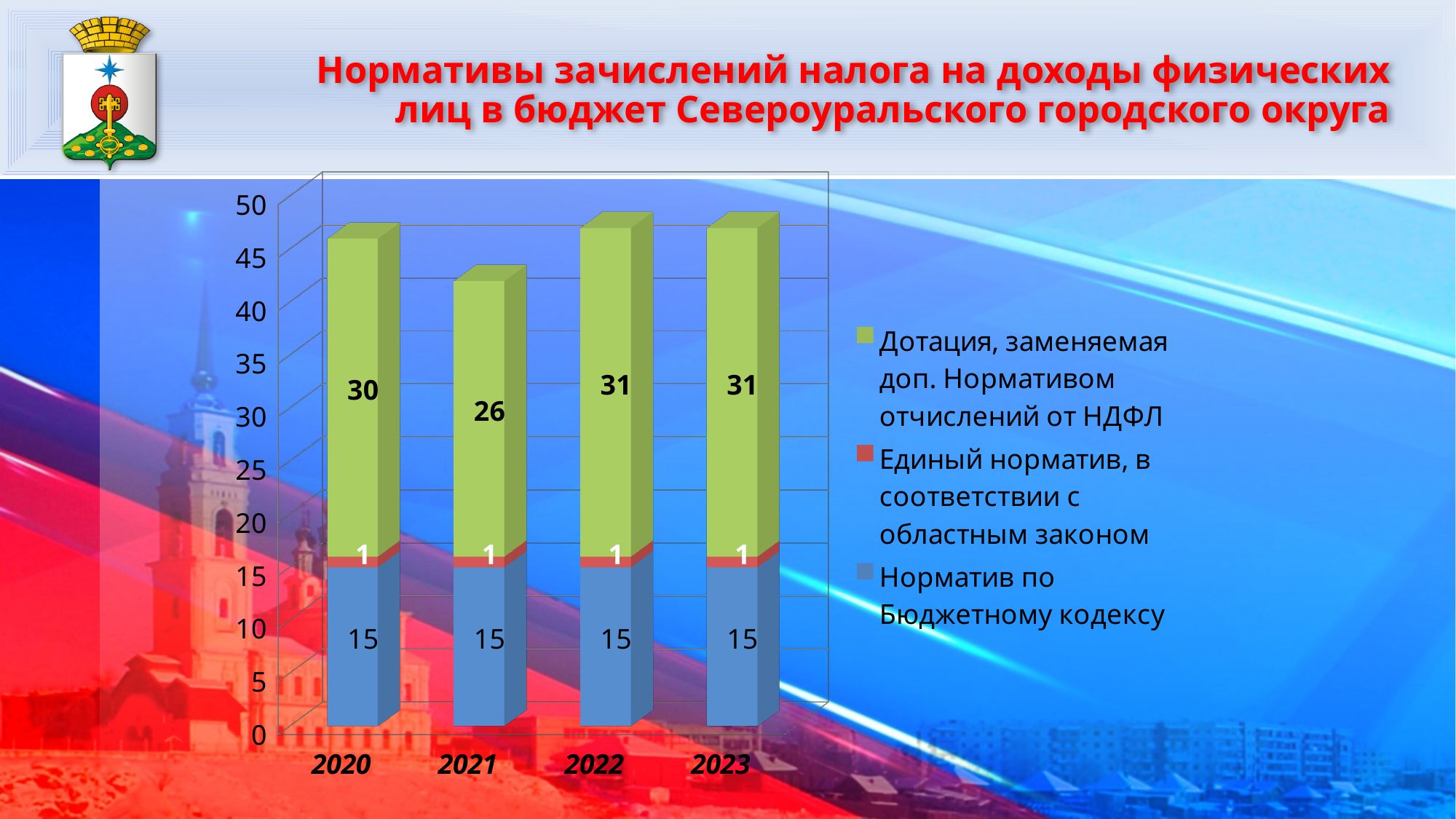
How many years are shown on the x axis? 4 What is the value of 'Дотация, заменяемая доп. Нормативом отчислений от НДФЛ' for 2021? 26 How many series does the legend list? 3 In which year is the value of 'Дотация, заменяемая доп. Нормативом отчислений от НДФЛ' lowest? 2021 What is the value of 'Норматив по Бюджетному кодексу' for 2023? 15 Which series is shown in green? Дотация, заменяемая доп. Нормативом отчислений от НДФЛ What is the difference between the 'Дотация, заменяемая доп. Нормативом отчислений от НДФЛ' values for 2022 and 2021? 5 What is the value of 'Единый норматив, в соответствии с областным законом' for 2020? 1 Which is larger: the 'Дотация, заменяемая доп. Нормативом отчислений от НДФЛ' value for 2020 or for 2023? 2023 What is the total of the stacked bar for 2021? 42 What type of chart is shown on the slide? stacked bar chart What is the total of the stacked bar for 2020? 46